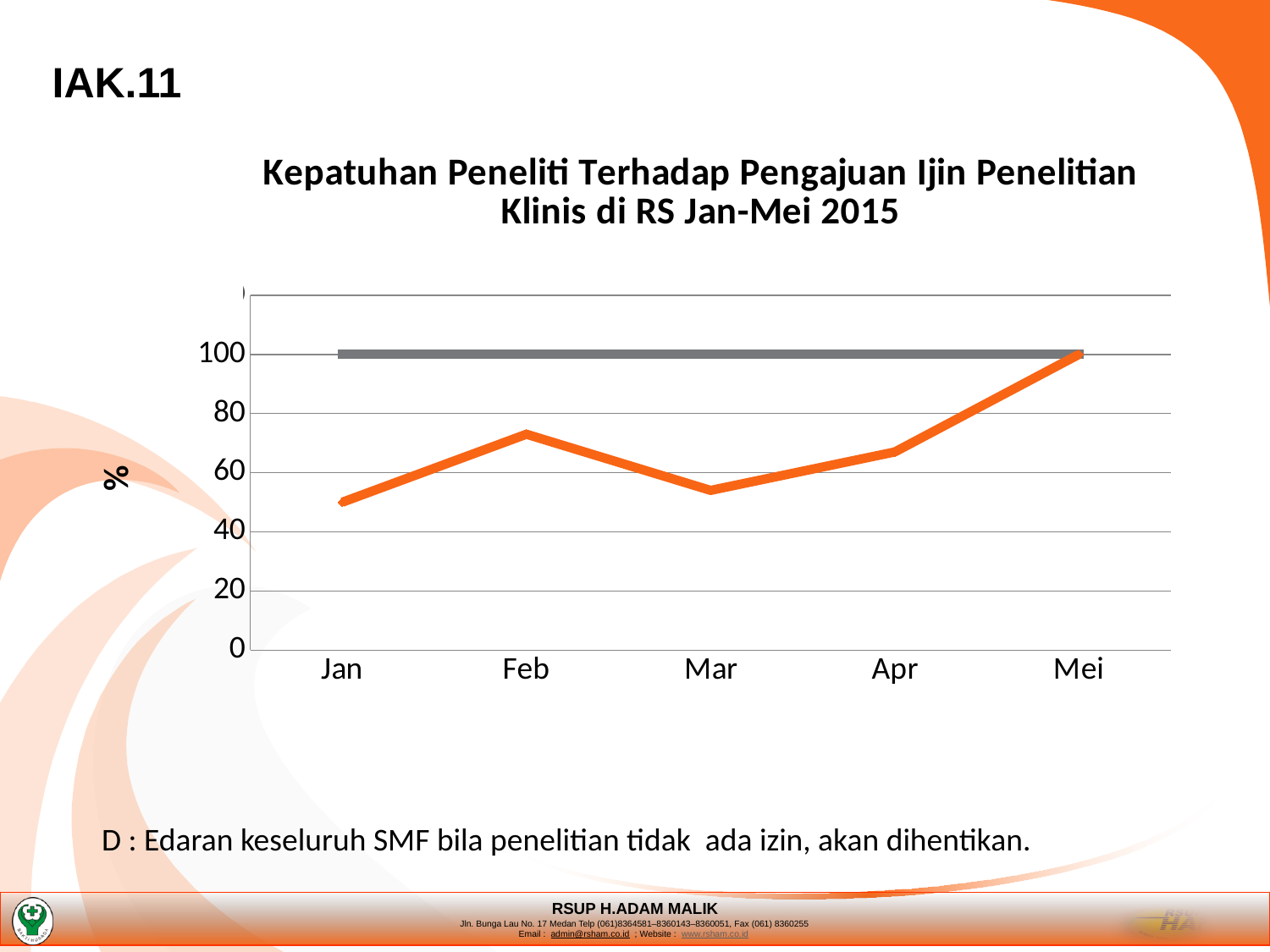
What is the label on the vertical axis of the chart? % What kind of chart is shown on the slide? line chart Which is larger, the value for Feb or the value for Mar? Feb Is the value for Jan greater or less than 60? less What is the value of the orange line for Mei? 100 At what level does the flat gray line sit on the chart? 100 Is the value for Apr greater or less than 80? less Which month has the highest value on the orange line? Mei How many months are shown on the x axis of the chart? 5 Is the value for Mar greater or less than 60? less Do the values on the orange line rise or fall from Mar to Mei? rise